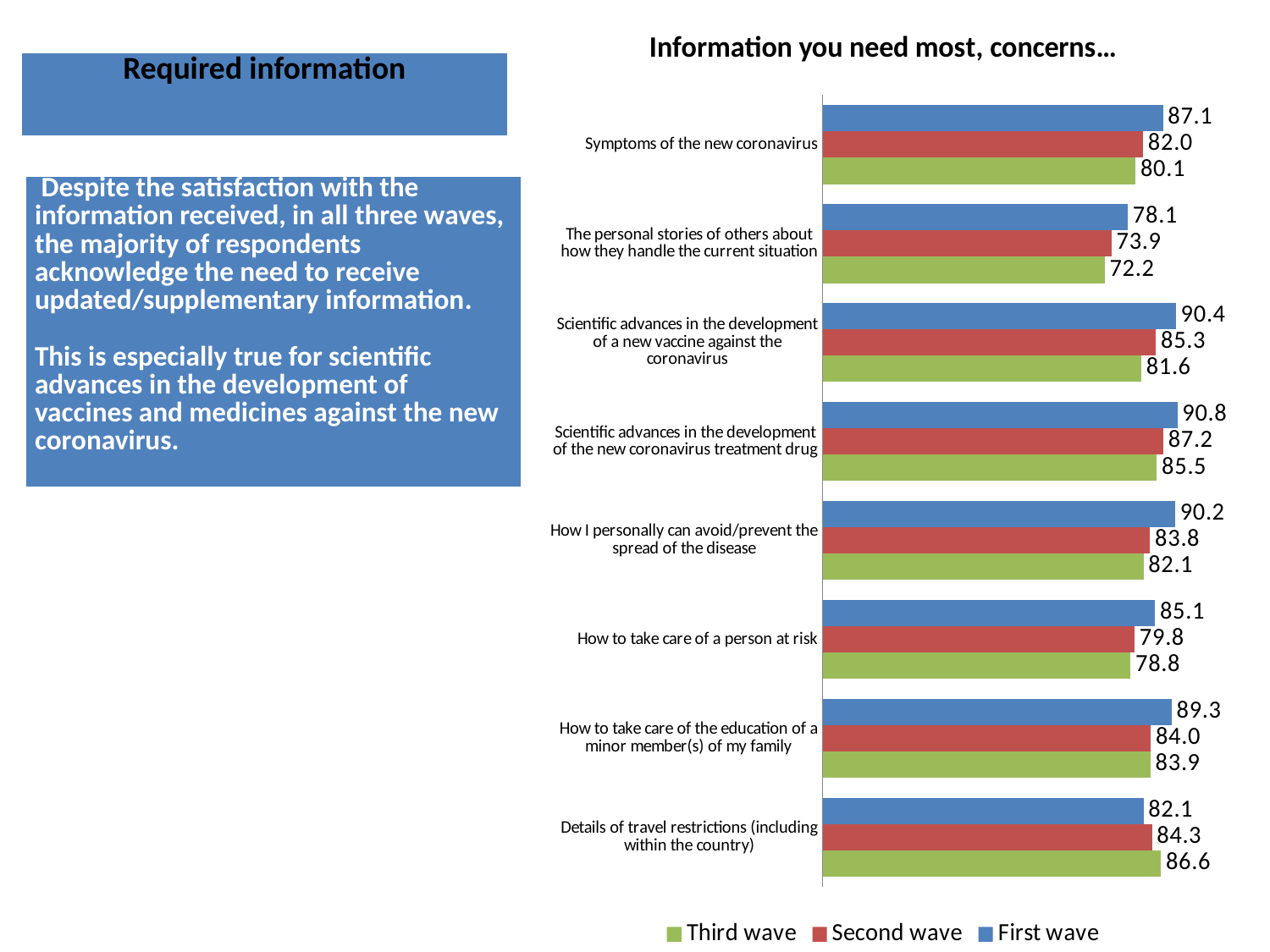
Which category has the lowest Third wave value? The personal stories of others about how they handle the current situation Which category has the highest First wave value? Scientific advances in the development of the new coronavirus treatment drug What is the title of the chart? Information you need most, concerns… For 'Details of travel restrictions (including within the country)', which is larger: the First wave value or the Third wave value? Third wave What is the Third wave value for 'Details of travel restrictions (including within the country)'? 86.6 Which series is shown in green in the legend? Third wave What is the Second wave value for 'How to take care of a person at risk'? 79.8 What is the difference between the First wave and Third wave values for 'Scientific advances in the development of a new vaccine against the coronavirus'? 8.8 How many categories are shown on the chart? 8 What is the First wave value for 'Symptoms of the new coronavirus'? 87.1 What kind of chart is shown on the slide? bar chart How many series does the legend list? 3